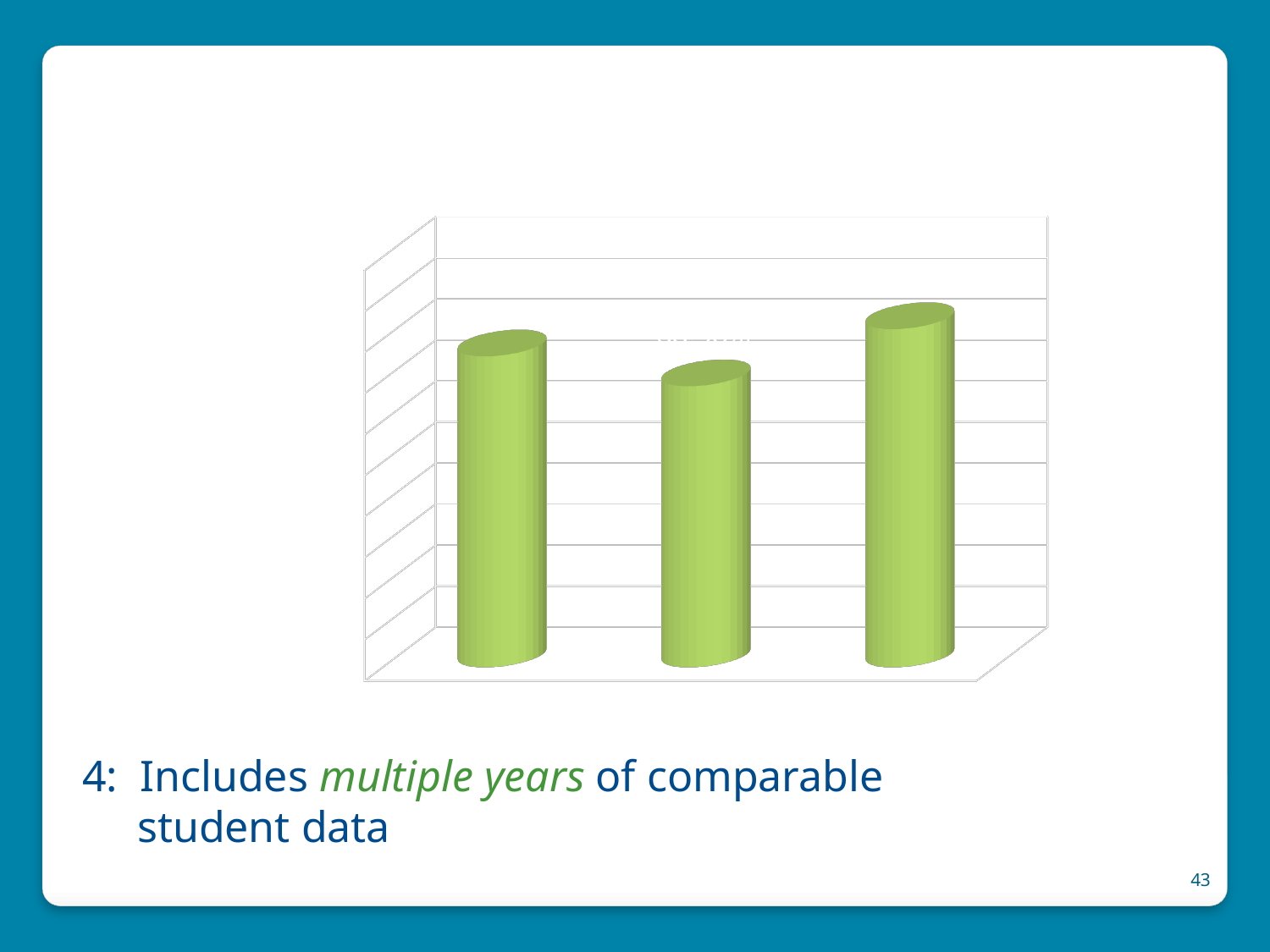
What colour are the bars in the chart? green Do the bar heights rise steadily from left to right? No Is the middle bar taller or shorter than the right bar? shorter Is the left bar taller or shorter than the middle bar? taller Does the chart display a legend? No What kind of chart is shown on the slide? bar chart Is the right bar taller or shorter than the left bar? taller Which bar is the shortest: the left, middle, or right bar? middle Which bar is the tallest: the left, middle, or right bar? right How many bars does the chart show? 3